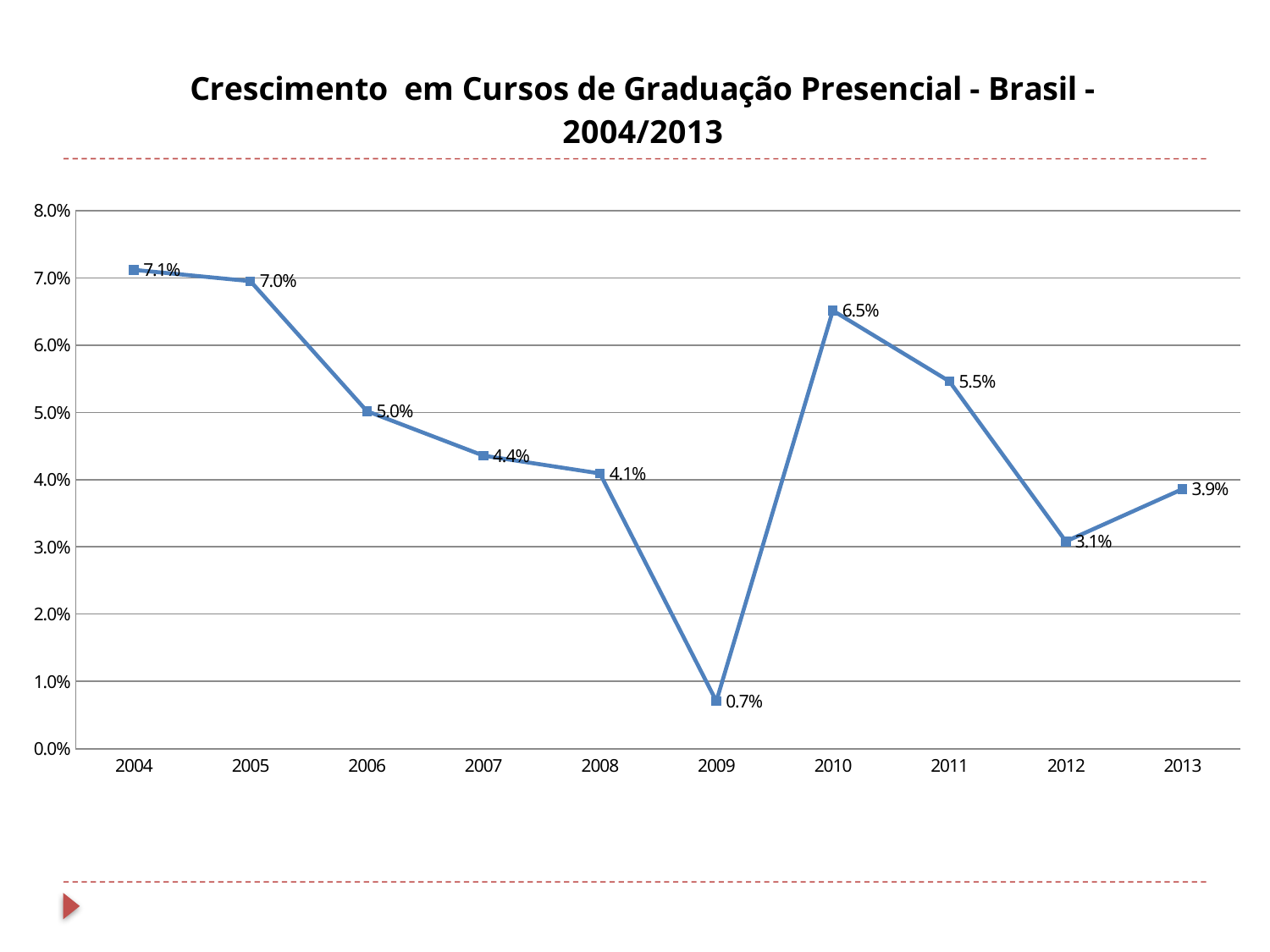
What is the value for 2010? 6.5% Which year has the highest value? 2004 How many years are plotted on the chart? 10 What is the difference between the values for 2004 and 2005? 0.1% What is the difference between the values for 2010 and 2011? 1.0% What kind of chart is shown? line chart Do the values rise or fall from 2004 to 2008? fall What is the value for 2013? 3.9% Which is larger, the value for 2006 or the value for 2012? 2006 Is the value for 2008 greater or less than 5.0%? less Which year has the lowest value? 2009 What is the value for 2009? 0.7%